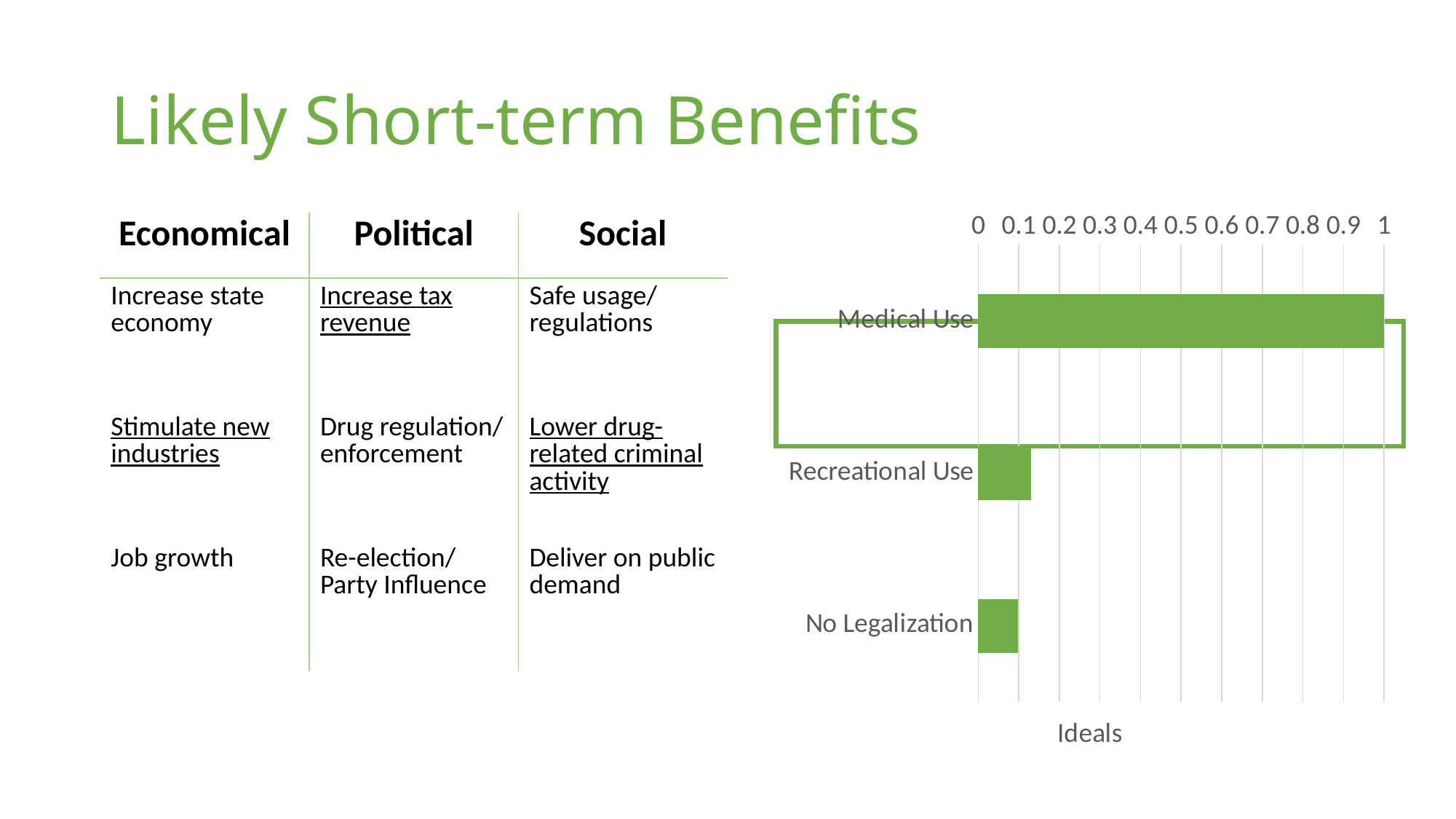
Which is larger in the bar chart, Medical Use or Recreational Use? Medical Use How many categories are plotted in the bar chart? 3 Is the value for Medical Use greater or less than 0.5? greater What is the maximum value shown on the horizontal axis of the bar chart? 1 What kind of chart is shown on the right side of the slide? bar chart Which category has the highest value in the bar chart? Medical Use What is the title of the horizontal axis of the bar chart? Ideals Which is larger in the bar chart, Medical Use or No Legalization? Medical Use What is the value for Medical Use in the bar chart? 1 Is the value for Recreational Use greater or less than 0.5? less Is the value for No Legalization greater or less than 0.5? less